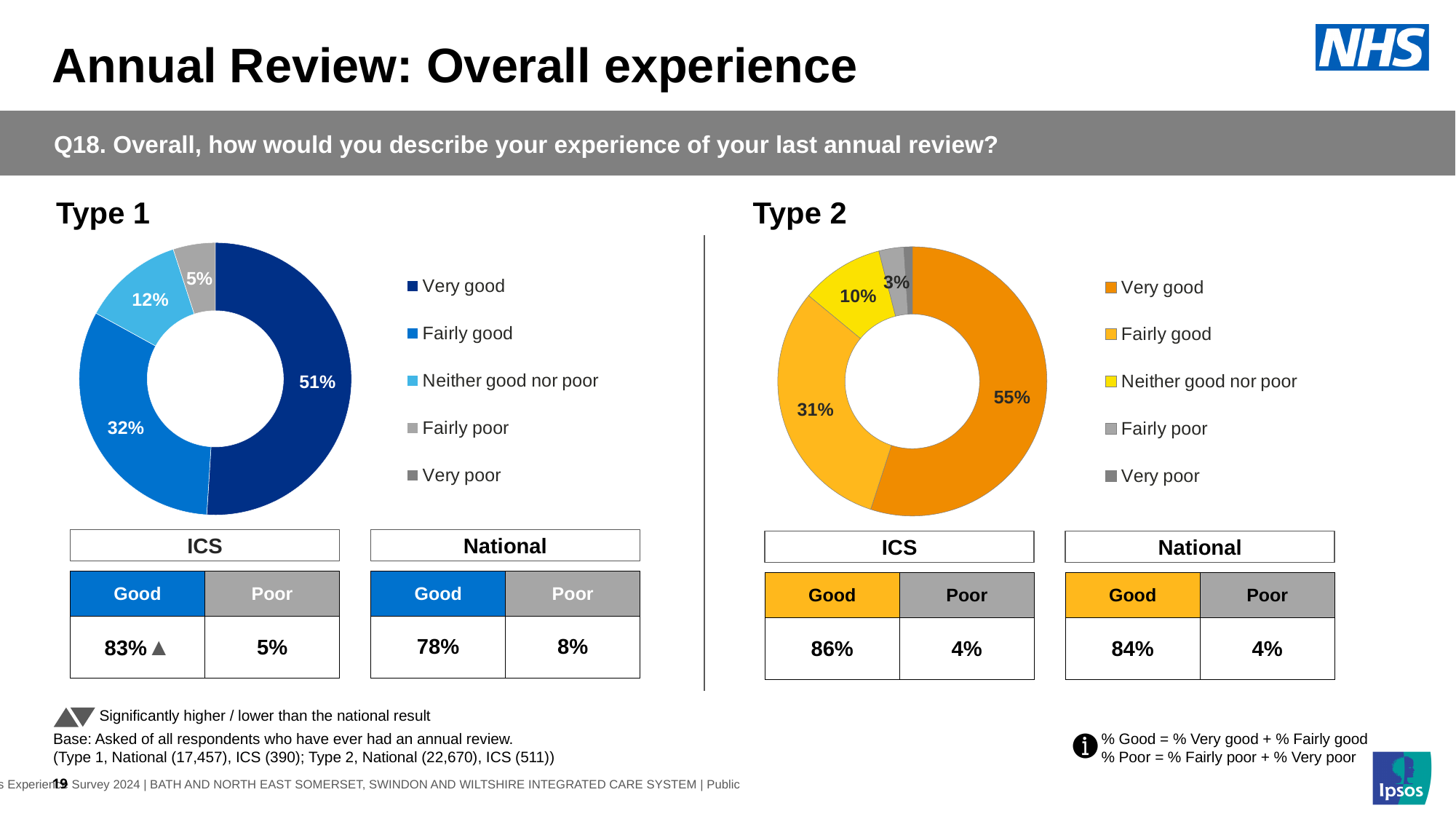
In the Type 1 chart, which response category has the largest share? Very good In the Type 1 chart, what percentage of respondents said their experience was Very good? 51% How many response categories does the legend of the Type 1 chart list? 5 In the Type 1 chart, what percentage of respondents said their experience was Fairly good? 32% In the Type 1 chart, what colour represents Very good? Dark blue In the Type 1 chart, what is the difference between the Very good and Fairly good percentages? 19 percentage points What kind of chart is used to show the Type 2 results? Pie (donut) chart Which chart shows a larger Very good share, Type 1 or Type 2? Type 2 In the Type 2 chart, which response category has the largest share? Very good In the Type 2 chart, what percentage of respondents said their experience was Very good? 55% In the Type 2 chart, what is the difference between the Very good and Fairly good percentages? 24 percentage points In the Type 2 chart, what percentage of respondents said Neither good nor poor? 10%